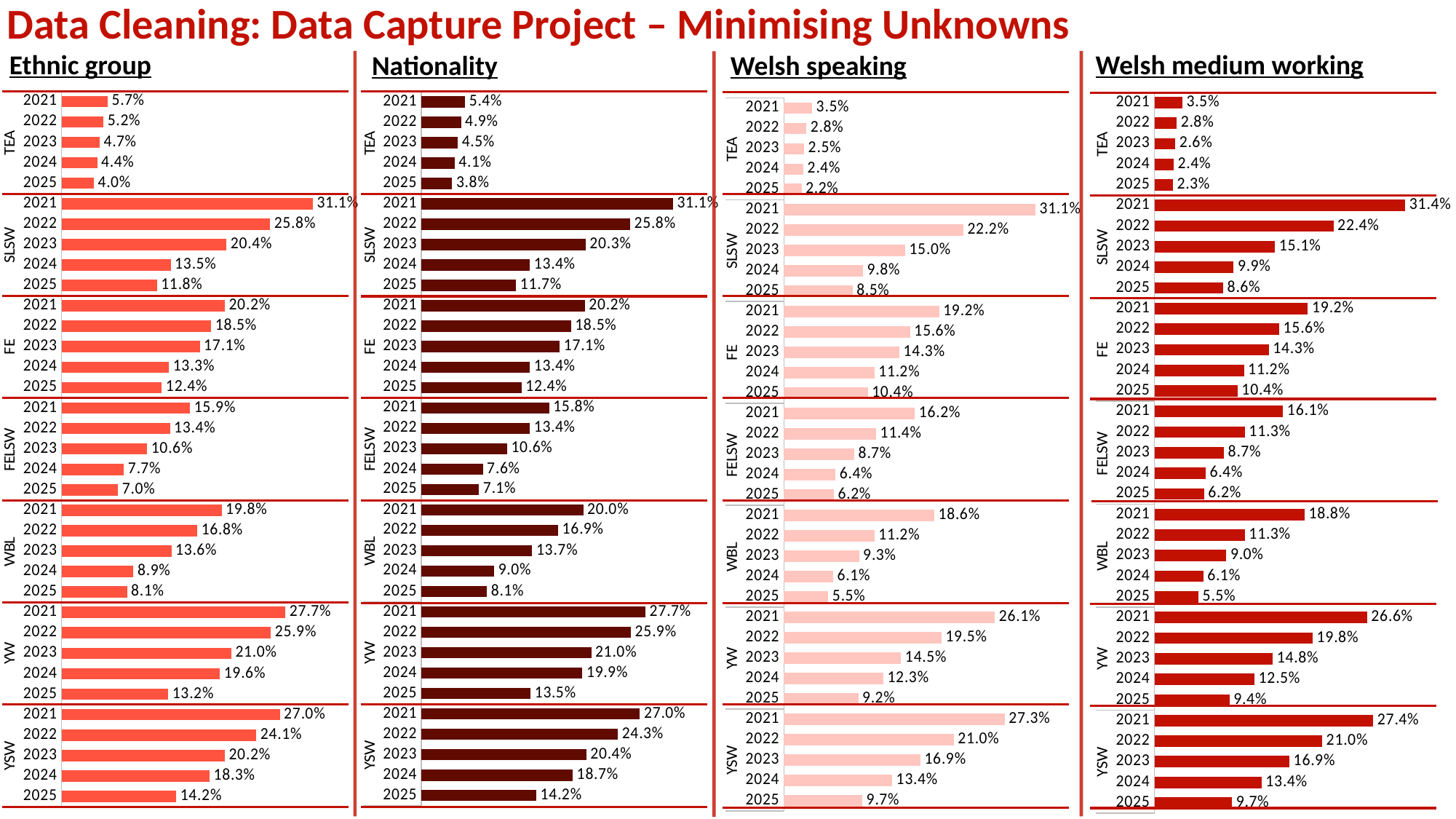
How many charts are shown on the slide? 4 In the Ethnic group chart, which year has the lowest value for TEA? 2025 In the Nationality chart, what is the difference between the FE values for 2021 and 2025? 7.8% How many years are plotted for each group in the Welsh medium working chart? 5 In the Welsh speaking chart, which is larger: the YSW value for 2022 or the YW value for 2022? YSW 2022 In the Welsh medium working chart, what is the value for YW in 2022? 19.8% In the Welsh medium working chart, which year has the highest value for SLSW? 2021 In the Ethnic group chart, what is the value for SLSW in 2021? 31.1% In the Nationality chart, what is the value for YSW in 2025? 14.2% What kind of chart is used in the Nationality panel? bar chart In the Ethnic group chart, do the FELSW values rise or fall from 2021 to 2025? fall In the Welsh speaking chart, what is the value for WBL in 2023? 9.3%